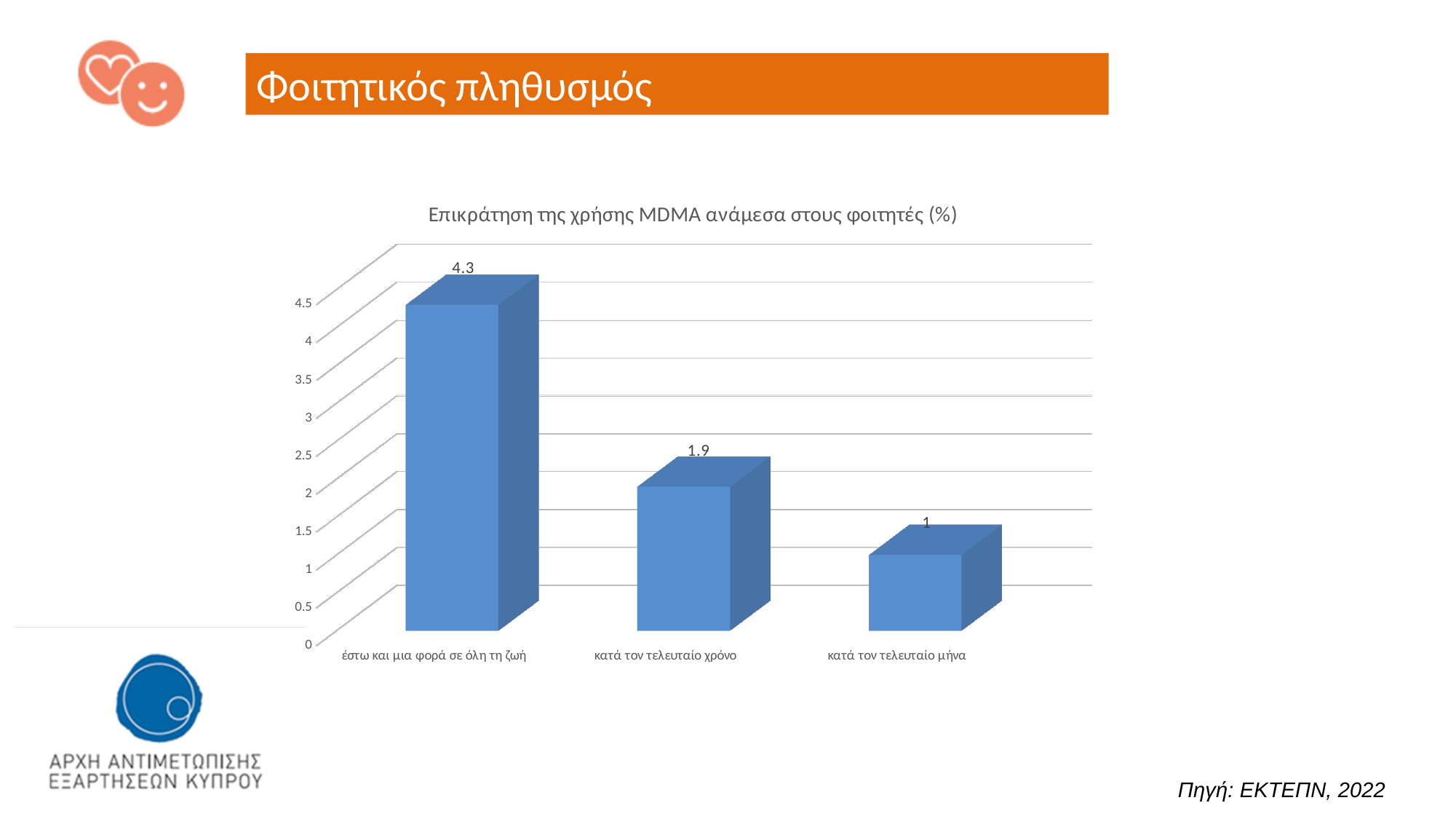
Is the value for 'έστω και μια φορά σε όλη τη ζωή' greater or less than 4? greater What is the value for 'έστω και μια φορά σε όλη τη ζωή'? 4.3 What is the value for 'κατά τον τελευταίο χρόνο'? 1.9 What is the difference between the values for 'έστω και μια φορά σε όλη τη ζωή' and 'κατά τον τελευταίο χρόνο'? 2.4 Which is larger: the value for 'κατά τον τελευταίο χρόνο' or 'κατά τον τελευταίο μήνα'? κατά τον τελευταίο χρόνο What is the difference between the values for 'κατά τον τελευταίο χρόνο' and 'κατά τον τελευταίο μήνα'? 0.9 Which category has the lowest value? κατά τον τελευταίο μήνα What kind of chart is shown on the slide? bar chart What is the title of the chart? Επικράτηση της χρήσης MDMA ανάμεσα στους φοιτητές (%) What is the value for 'κατά τον τελευταίο μήνα'? 1 How many categories are shown in the chart? 3 Which category has the highest value? έστω και μια φορά σε όλη τη ζωή